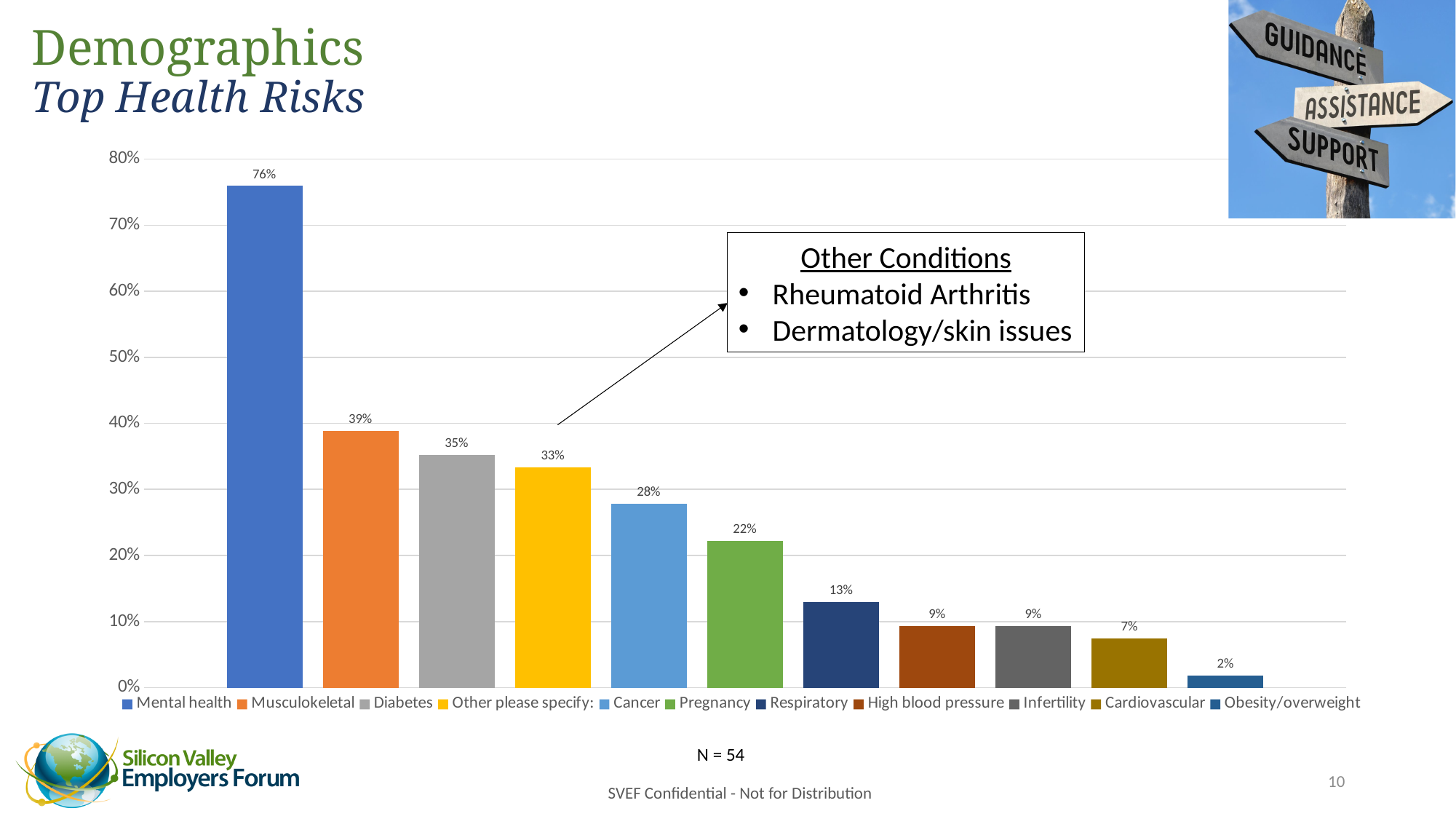
Which is larger, the value for Respiratory or the value for Infertility? Respiratory Is the value for Other please specify: greater or less than 30%? greater What is the value for Cardiovascular? 7% What is the value for Cancer? 28% What is the value for Mental health? 76% What is the difference between the values for Mental health and Pregnancy? 54% Which category has the highest value? Mental health What is the difference between the values for Musculoskeletal and Diabetes? 4% How many categories are shown in the chart? 11 What kind of chart is shown on the slide? bar chart Do the values rise or fall from left to right along the x axis? fall Which category has the lowest value? Obesity/overweight